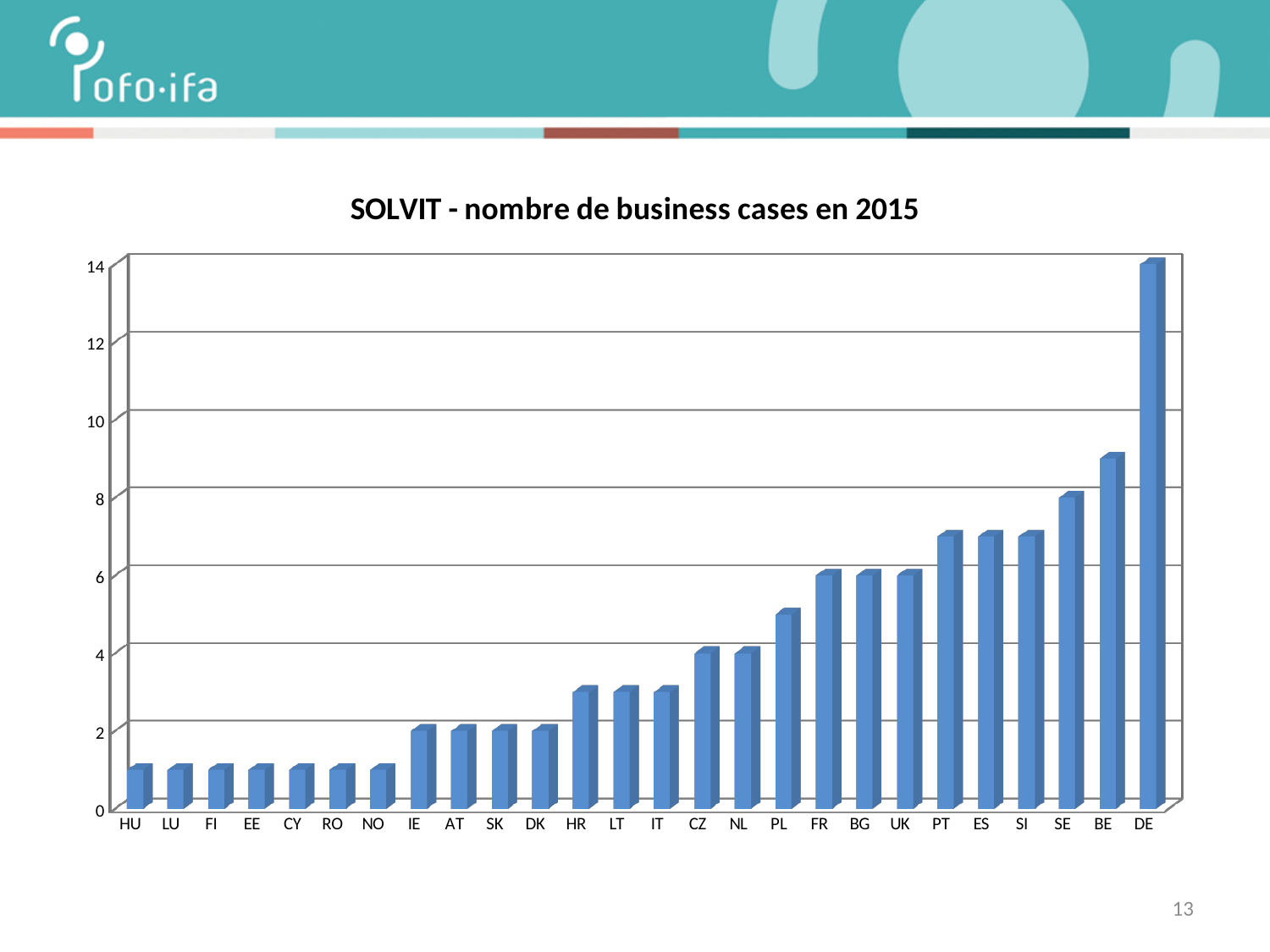
What is the difference between the values for DE and SE? 6 Which country has the highest number of business cases in the chart? DE What is the title of the chart? SOLVIT - nombre de business cases en 2015 What is the value for DE in the chart? 14 Which has a larger value, DE or BE? DE What is the value for SE in the chart? 8 What is the value for FR in the chart? 6 What kind of chart is shown on the slide? bar chart Do the values generally rise or fall from left to right along the x axis? rise How many countries are shown on the x axis of the chart? 26 What is the value for CZ in the chart? 4 Is the value for PL greater or less than 4? greater